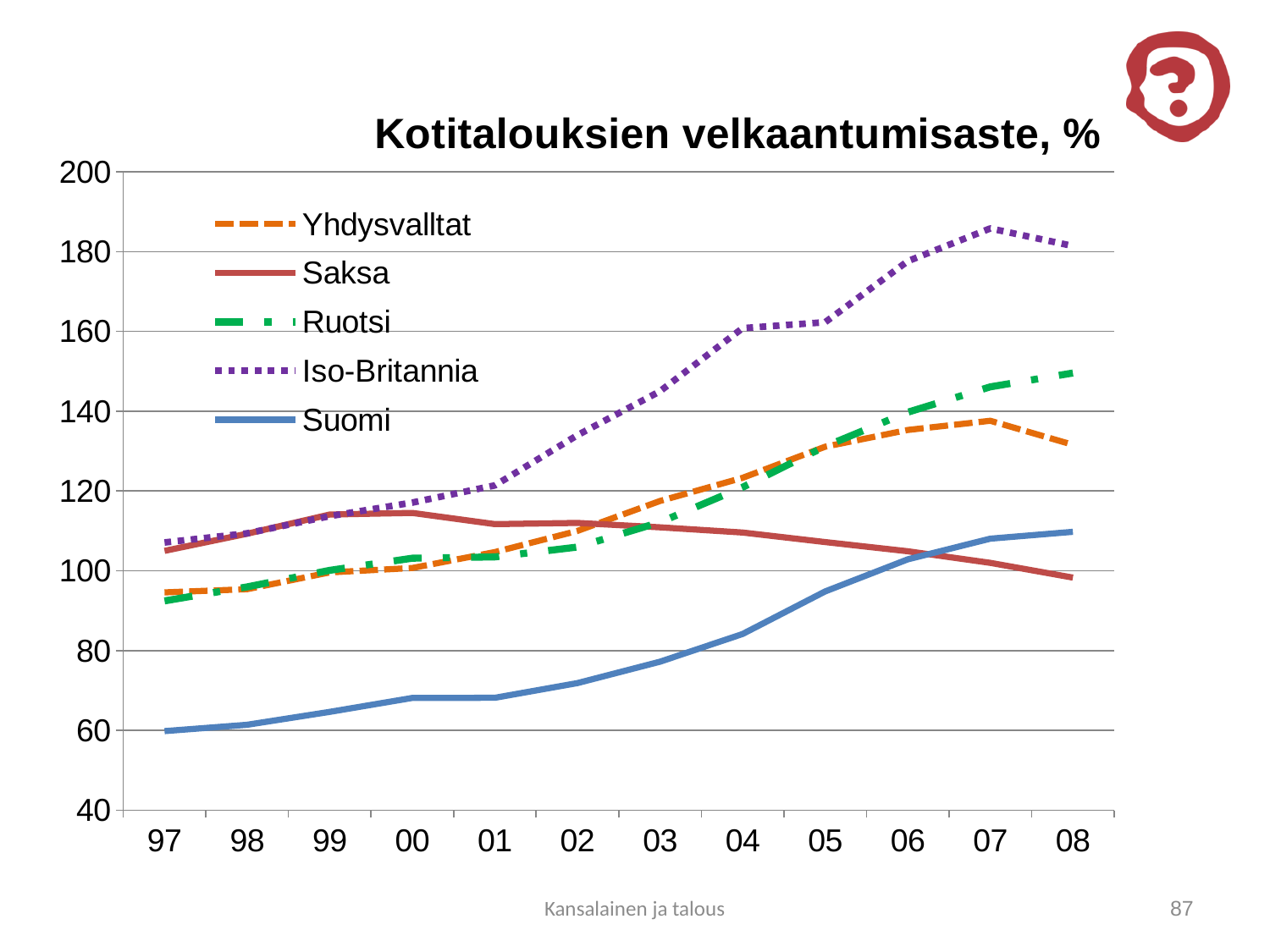
Which series has the lowest value in 97? Suomi What is the title of the chart? Kotitalouksien velkaantumisaste, % What kind of chart is shown on the slide? line chart In 08, which is larger, the value for Ruotsi or the value for Yhdysvallat? Ruotsi Which series has the highest value in 08? Iso-Britannia Is the value for Suomi in 97 greater or less than 80? less Does the value for Suomi rise or fall from 97 to 08? rise How many series does the legend list? 5 Is the value for Iso-Britannia in 07 greater or less than 180? greater Is the value for Ruotsi in 08 greater or less than 140? greater How many years are shown on the x axis? 12 Which series has the lowest value in 08? Saksa